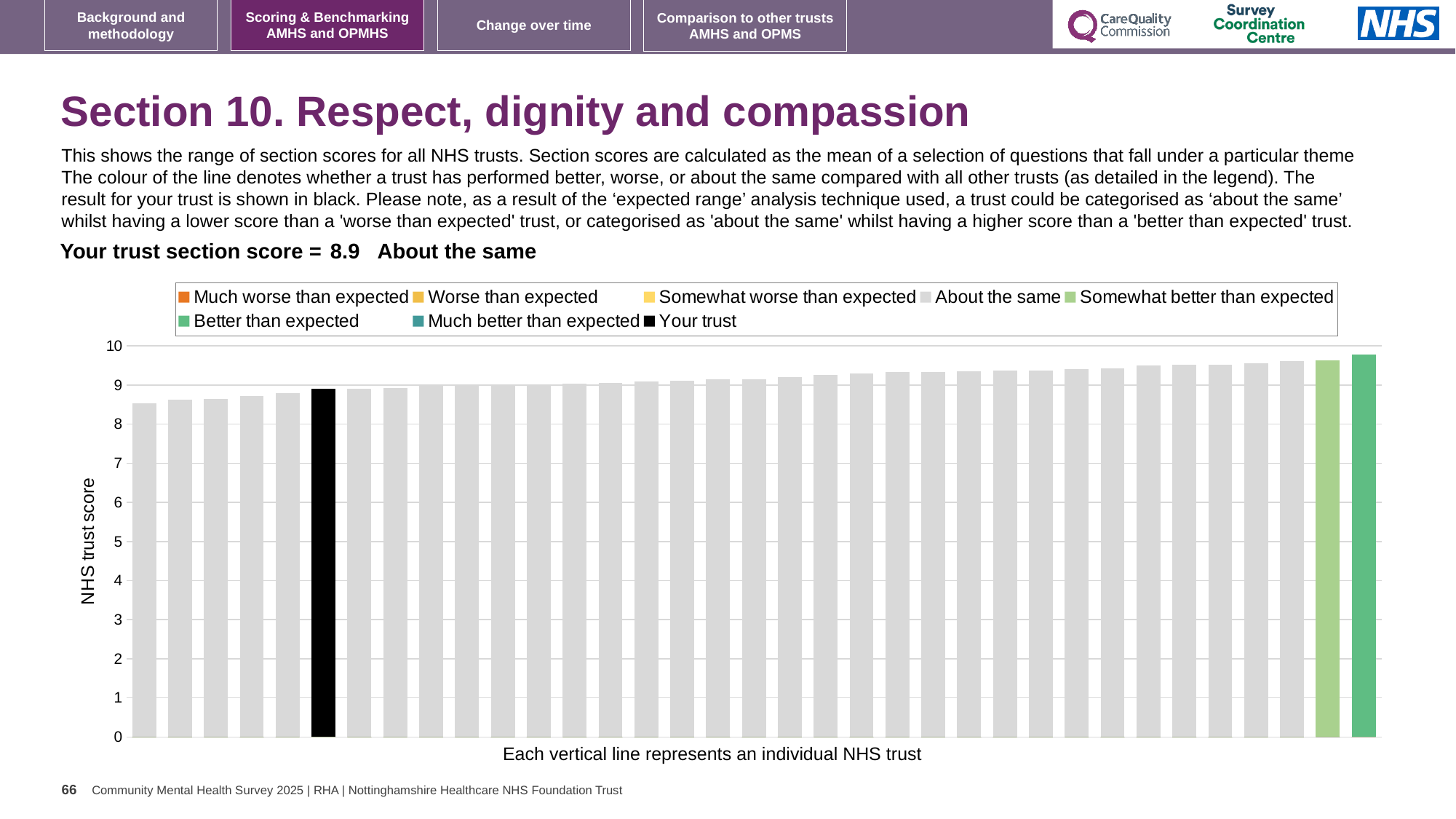
Which legend category does the lowest bar (leftmost) belong to? About the same What colour is the bar representing your trust? Black Which legend category does the highest bar (rightmost) belong to? Better than expected What kind of chart is shown on the slide? Bar chart Is your trust's bar higher or lower than the rightmost bar? lower What is the label on the vertical axis of the chart? NHS trust score What is the section score for your trust? 8.9 Is the value for the leftmost bar greater or less than 9? less Is the value for the highest bar greater or less than 10? less Do the bar values rise or fall from left to right along the x axis? rise How many entries does the chart legend list? 8 Is the value for the leftmost bar greater or less than 8? greater